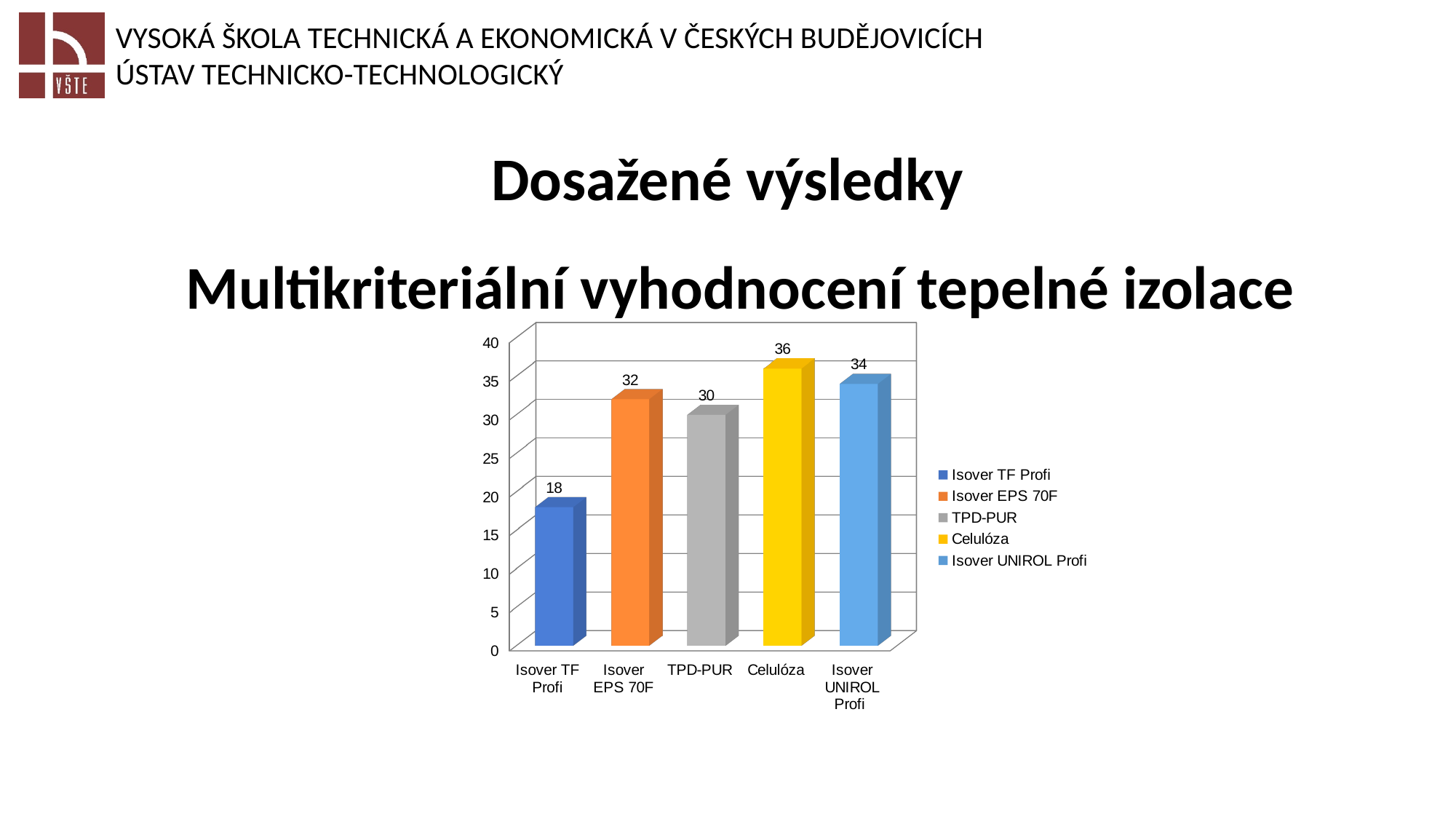
What is the value for TPD-PUR? 30 Which is larger, the value for Isover EPS 70F or the value for TPD-PUR? Isover EPS 70F How many categories are shown on the x axis? 5 What is the value for Isover TF Profi? 18 What is the difference between the values for Celulóza and Isover TF Profi? 18 What is the difference between the values for Isover UNIROL Profi and Isover EPS 70F? 2 Which category has the lowest value? Isover TF Profi What kind of chart is shown? bar chart What colour is the bar for Celulóza? yellow How many entries does the legend list? 5 Which category has the highest value? Celulóza What is the value for Celulóza? 36